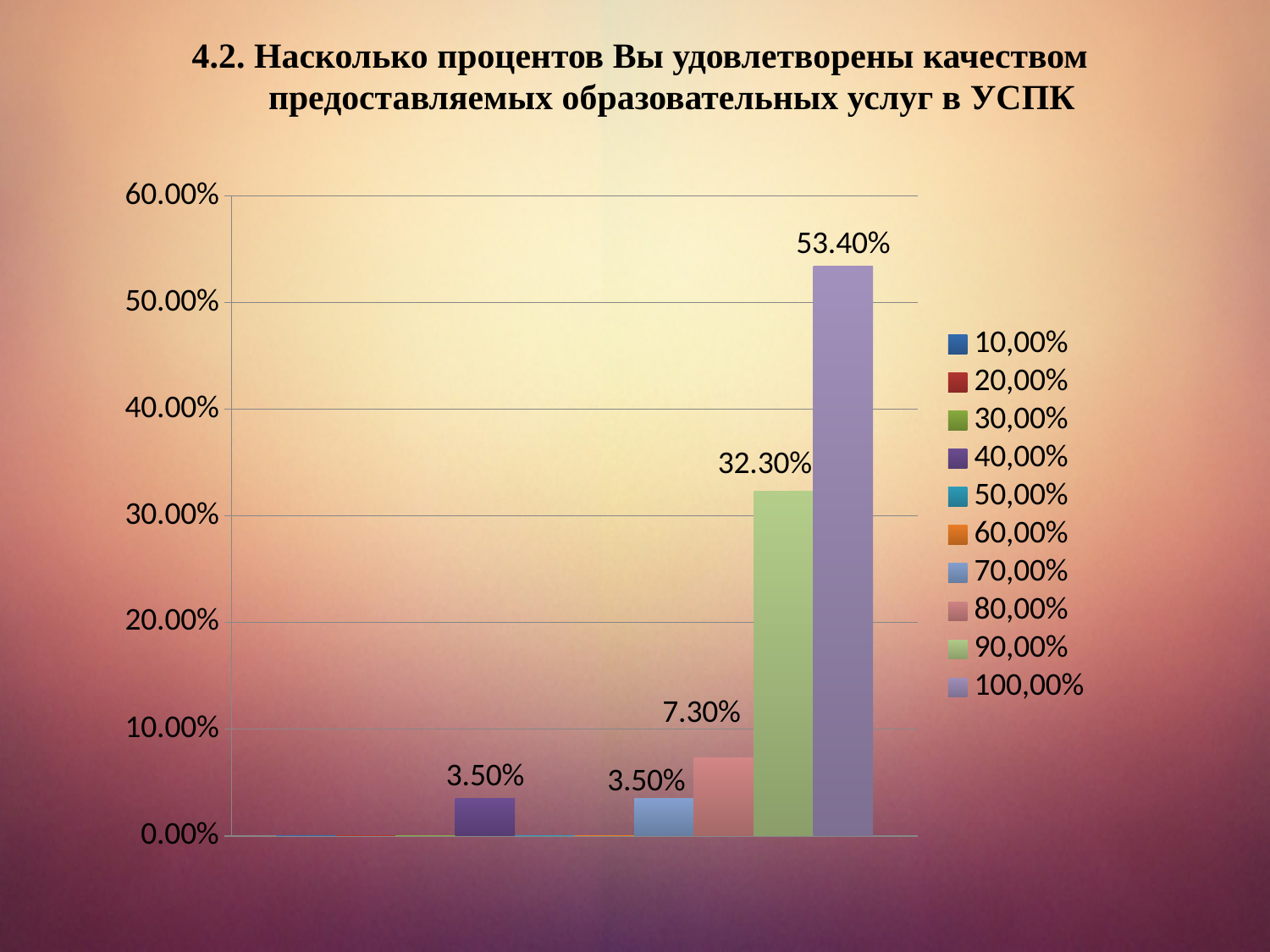
What kind of chart is shown on the slide? Bar chart How many series does the legend list? 10 What value is shown for the 40,00% series? 3.50% What colour is the bar for the 90,00% series? Green What value is shown for the 90,00% series? 32.30% What value is shown for the 80,00% series? 7.30% Which is larger, the value for the 90,00% series or the value for the 80,00% series? 90,00% What value is shown for the 100,00% series? 53.40% What is the difference between the values for the 100,00% and 90,00% series? 21.10% Which series has the highest value on the chart? 100,00% What is the difference between the values for the 80,00% and 70,00% series? 3.80% Is the value for the 100,00% series greater or less than 50.00%? greater